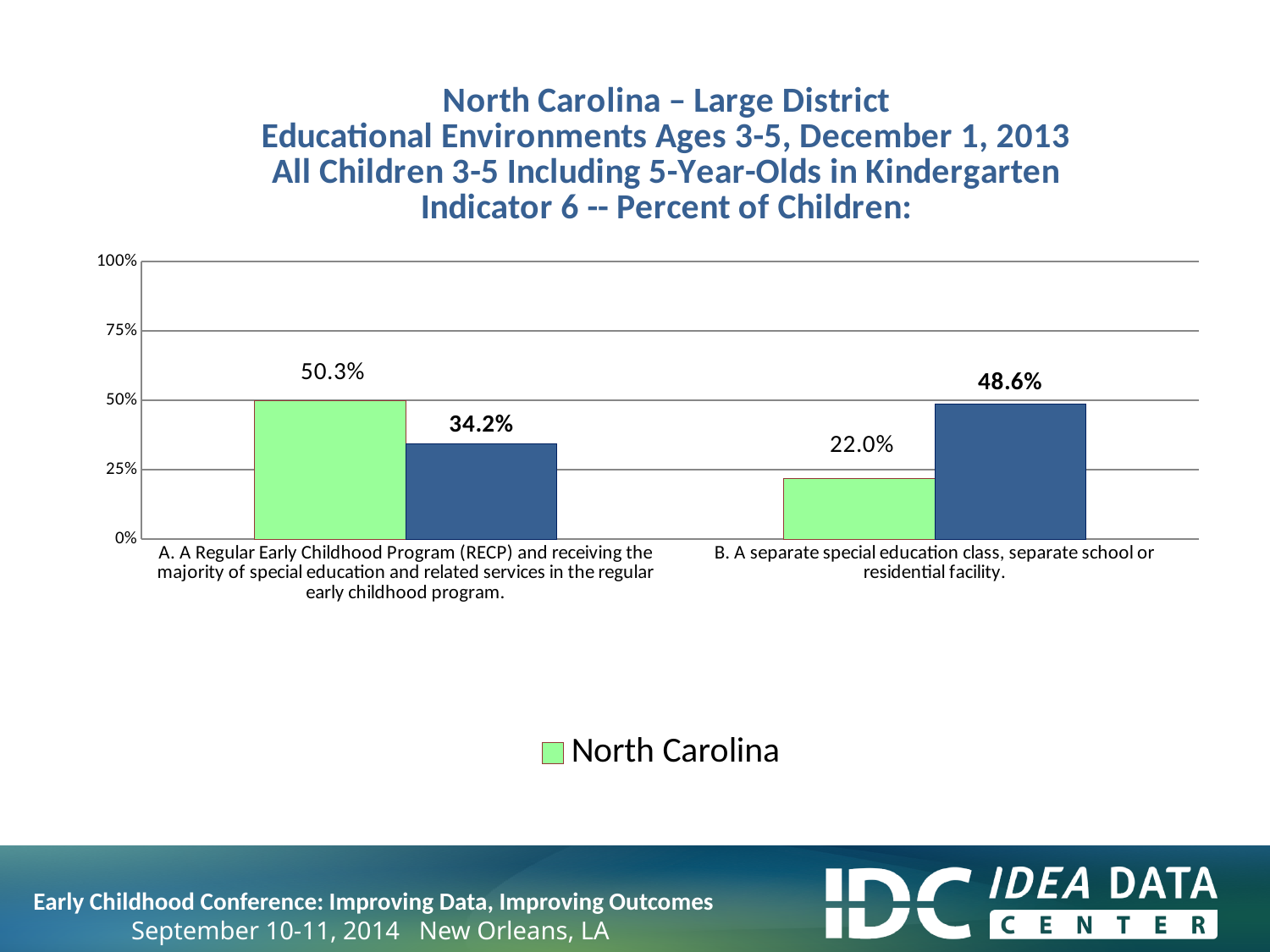
What is the North Carolina value for category B (A separate special education class, separate school or residential facility)? 22.0% How many series does the legend list? 1 What value is shown on the dark blue bar for category A? 34.2% What value is shown on the dark blue bar for category B? 48.6% How many categories are shown on the x axis? 2 For category B, which bar is larger, the green North Carolina bar or the dark blue bar? The dark blue bar What is the North Carolina value for category A (A Regular Early Childhood Program)? 50.3% For category B, how much higher is the dark blue bar than the North Carolina (green) bar? 26.6 percentage points Which bar has the highest value on the chart? North Carolina for category A, 50.3% What kind of chart is shown on the slide? Bar chart For category A, which bar is larger, the green North Carolina bar or the dark blue bar? The green North Carolina bar For category A, how much higher is the North Carolina (green) bar than the dark blue bar? 16.1 percentage points